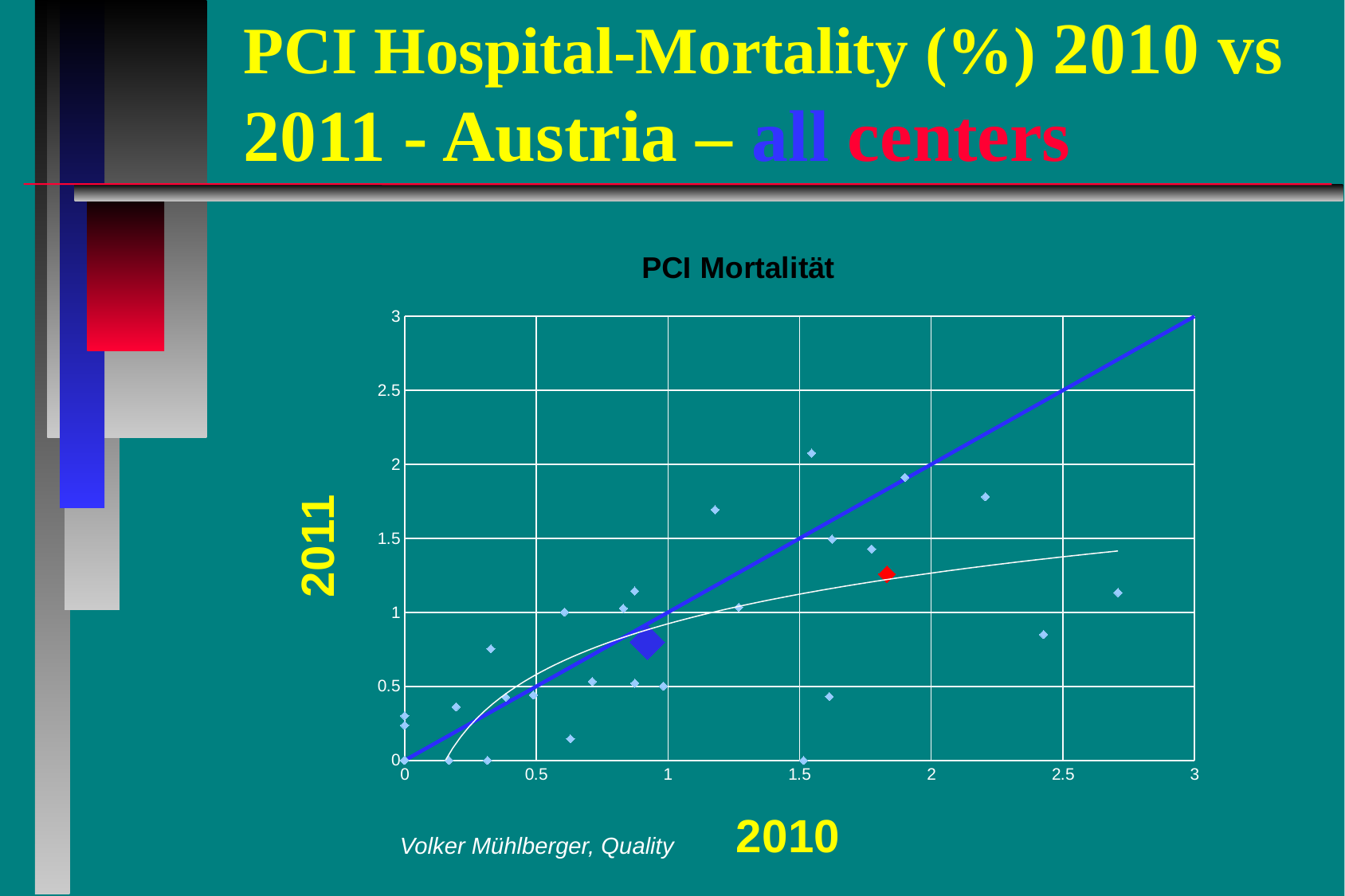
What kind of chart is shown on the slide? scatter chart Is the 2011 value (y-axis) of the large blue diamond marker greater or less than 1? less What is the title of the chart? PCI Mortalität Is the 2010 value (x-axis) of the large blue diamond marker greater or less than 1? less Is the 2010 value (x-axis) of the red diamond marker greater or less than 1.5? greater Does the thick blue diagonal line rise or fall from left to right across the chart? rises What is the label of the horizontal (x) axis of the chart? 2010 Which marker has the higher 2011 value, the large blue diamond or the red diamond? the red diamond